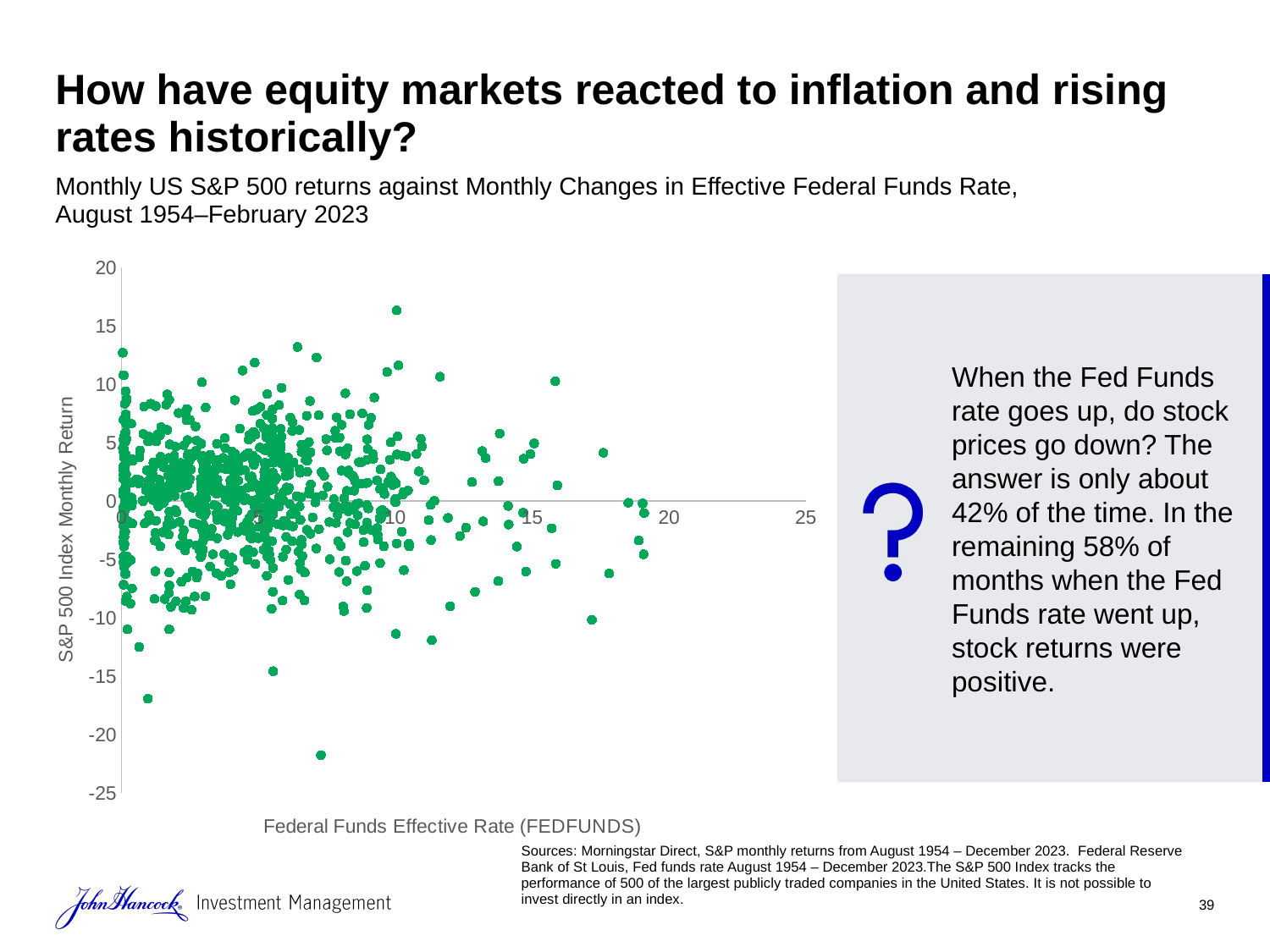
Is the Federal Funds rate of the highest plotted point (the largest S&P 500 monthly return) greater or less than 15? less Is the S&P 500 monthly return of the point plotted furthest to the right on the chart greater or less than 5? less What is the title of the horizontal axis of the chart? Federal Funds Effective Rate (FEDFUNDS) Is the S&P 500 monthly return of the highest plotted point greater or less than 15? greater What colour are the plotted points in the chart? Green What kind of chart is shown on the slide? Scatter chart